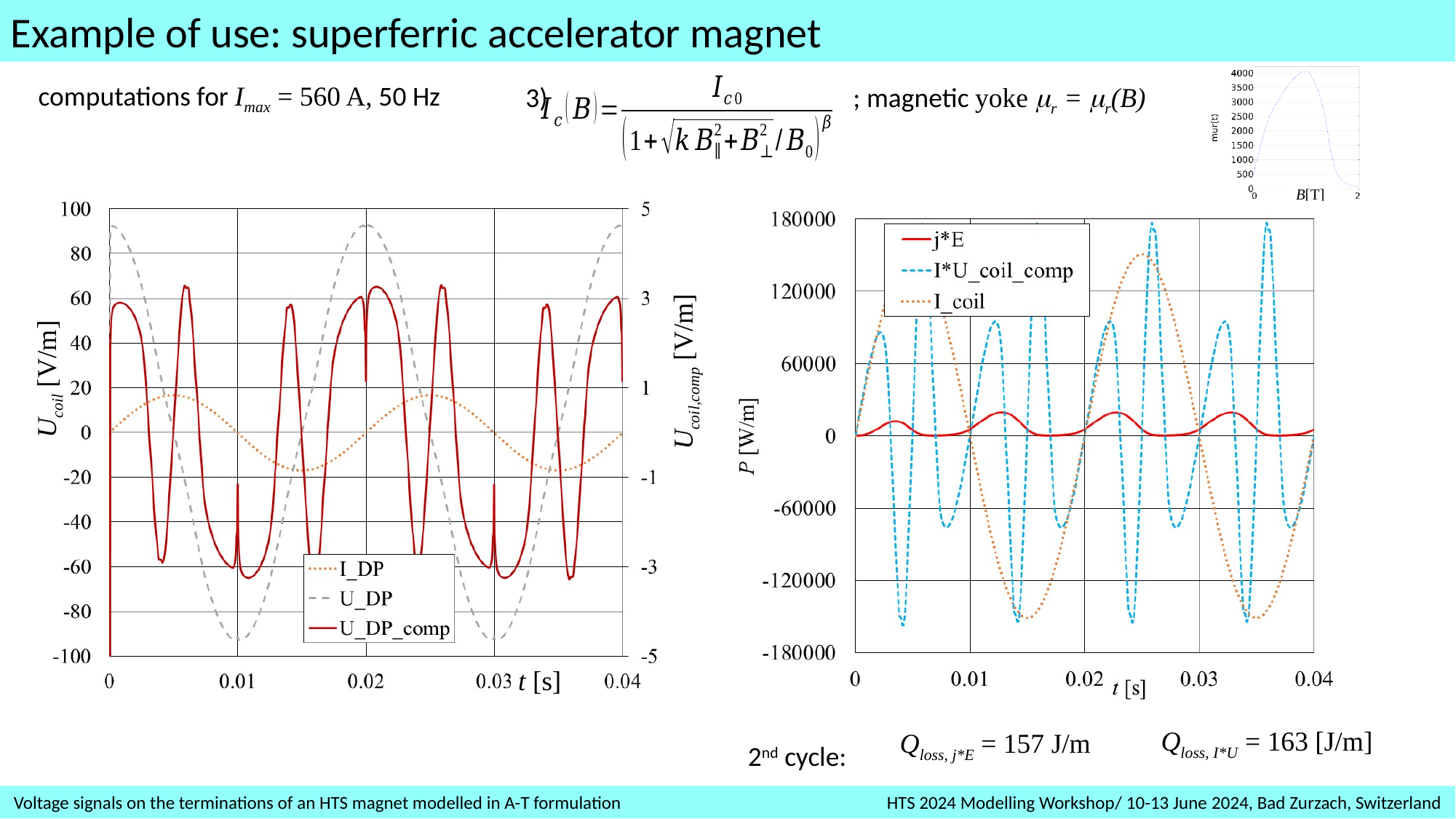
In the right chart (P [W/m]), which series reaches a higher peak, j*E or I*U_coil_comp? I*U_coil_comp In the left chart, is the peak value of I_DP on the left axis greater or less than 20? less What is the x-axis label of the left chart? t [s] How many series does the legend of the right chart (P [W/m]) list? 3 How many series does the legend of the left chart list? 3 In the left chart, which series reaches a higher peak on the left axis, I_DP or U_DP? U_DP In the right chart (P [W/m]), is the peak value of I*U_coil_comp greater or less than 120000? greater In the small inset chart at the top right (mur vs B[T]), is the peak value greater or less than 3500? greater What type of chart is the left chart with the U_DP legend? line chart What are the legend entries of the right chart (P [W/m])? j*E, I*U_coil_comp, I_coil